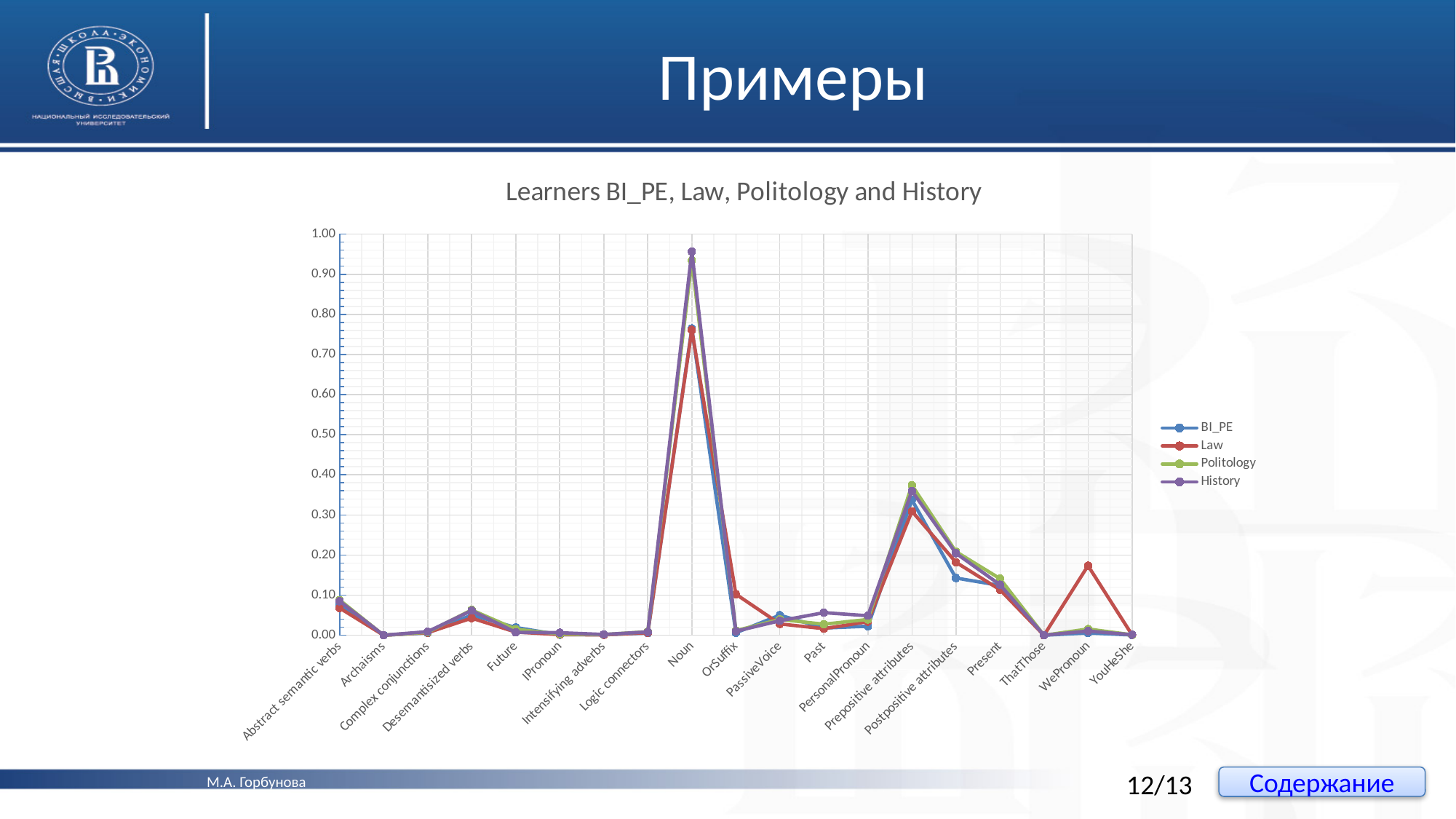
Is the value of the Law series for WePronoun greater or less than 0.10? greater How many series does the legend list? 4 How many categories are shown on the x axis? 19 For WePronoun, which series has the larger value, Law or BI_PE? Law For which category does the Law series reach its highest value? Noun For which category does the History series reach its highest value? Noun Which series are listed in the legend? BI_PE, Law, Politology, History Is the value of the Law series for Noun greater or less than 0.70? greater What is the title of the chart? Learners BI_PE, Law, Politology and History For Noun, which series has the larger value, History or Law? History Is the value of the History series for Noun greater or less than 0.90? greater What kind of chart is shown on the slide? line chart